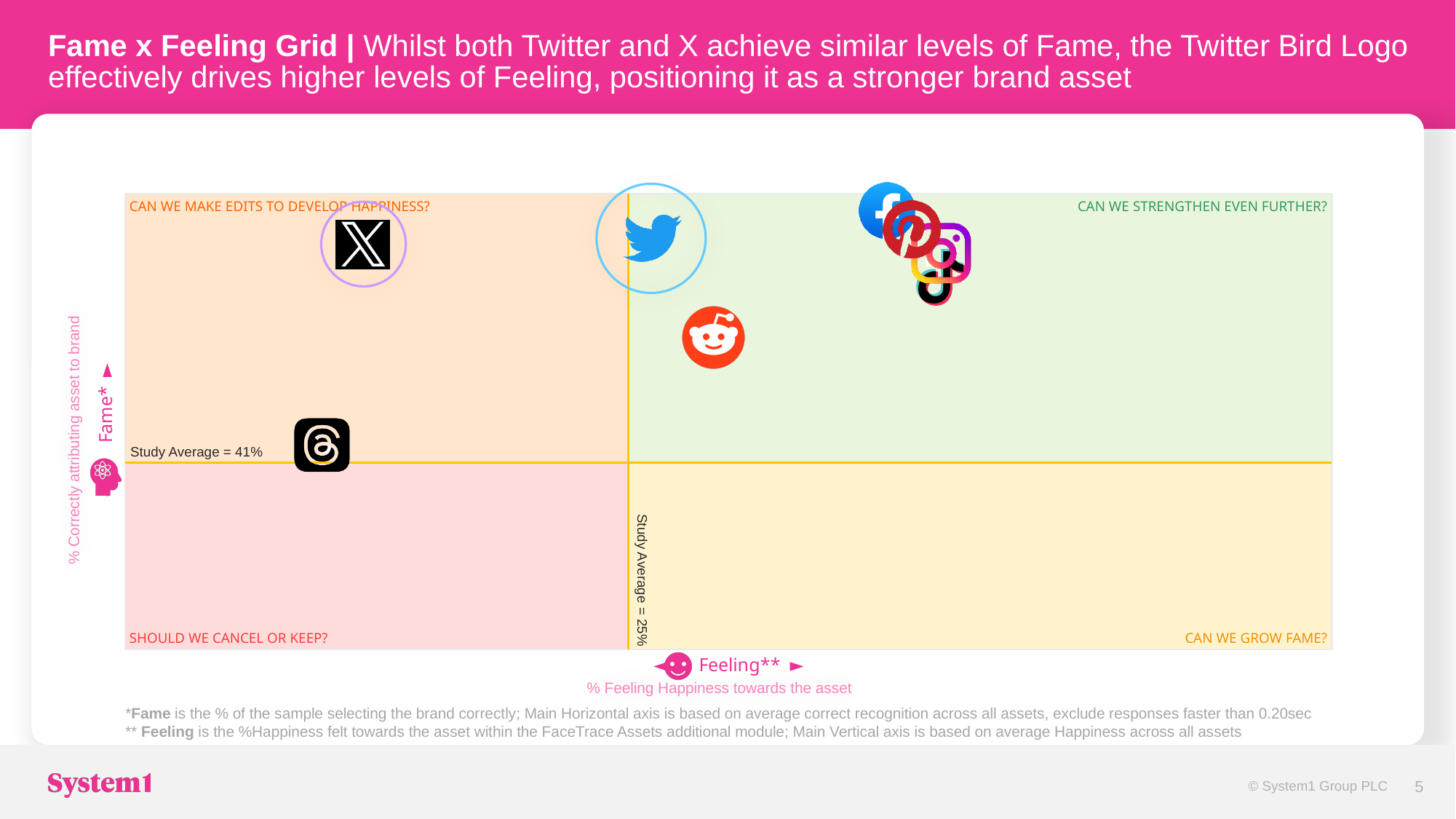
What is the Study Average for Feeling shown on the chart? 25% What is the Study Average for Fame shown on the chart? 41% Which has the higher Feeling value, the X logo or the Reddit logo? Reddit Which quadrant of the grid contains no logos? Both bottom quadrants (SHOULD WE CANCEL OR KEEP? and CAN WE GROW FAME?) Which logo has the lowest Fame on the grid? Threads Which logo has the lowest Feeling on the grid? Threads What is the label of the top-right quadrant of the grid? CAN WE STRENGTHEN EVEN FURTHER? Is the Feeling value for the X logo greater or less than 25%? less How many brand logos are plotted on the grid? 8 Is the Fame value for the X logo greater or less than 41%? greater What kind of chart is shown on the slide? Scatter chart (grid) Is the Feeling value for the Reddit logo greater or less than 25%? greater